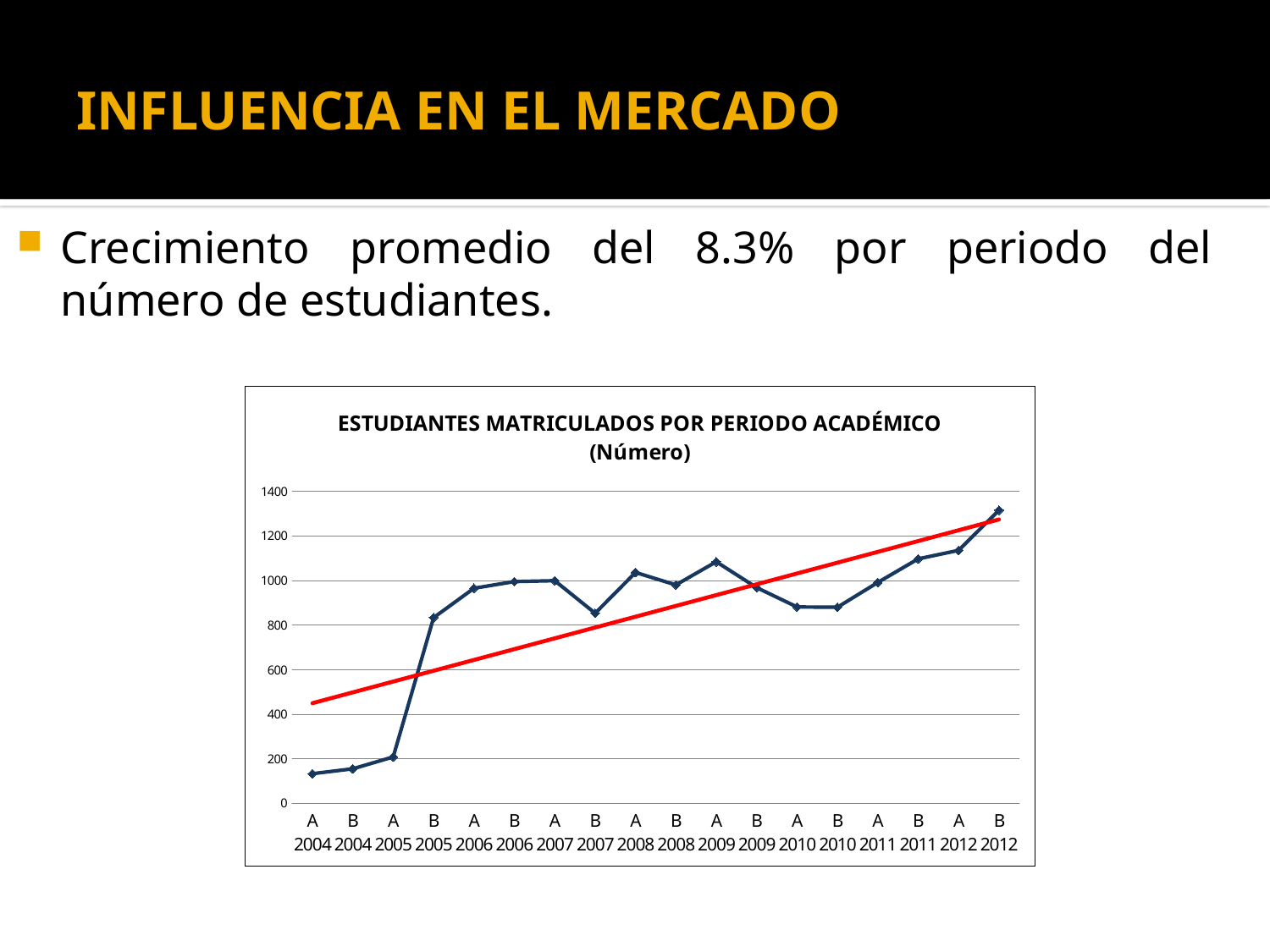
What kind of chart is shown on the slide? line chart Is the value for period B 2012 greater or less than 1200? greater Is the value for period A 2010 greater or less than 1000? less What is the title of the chart? ESTUDIANTES MATRICULADOS POR PERIODO ACADÉMICO (Número) Is the value for period B 2005 greater or less than 600? greater Which period has more enrolled students, A 2005 or B 2005? B 2005 Which academic period has the lowest number of enrolled students? A 2004 Overall, do the enrolled student numbers rise or fall from A 2004 to B 2012? rise Which period has more enrolled students, A 2009 or A 2010? A 2009 Which academic period has the highest number of enrolled students? B 2012 How many academic periods are plotted along the x axis of the chart? 18